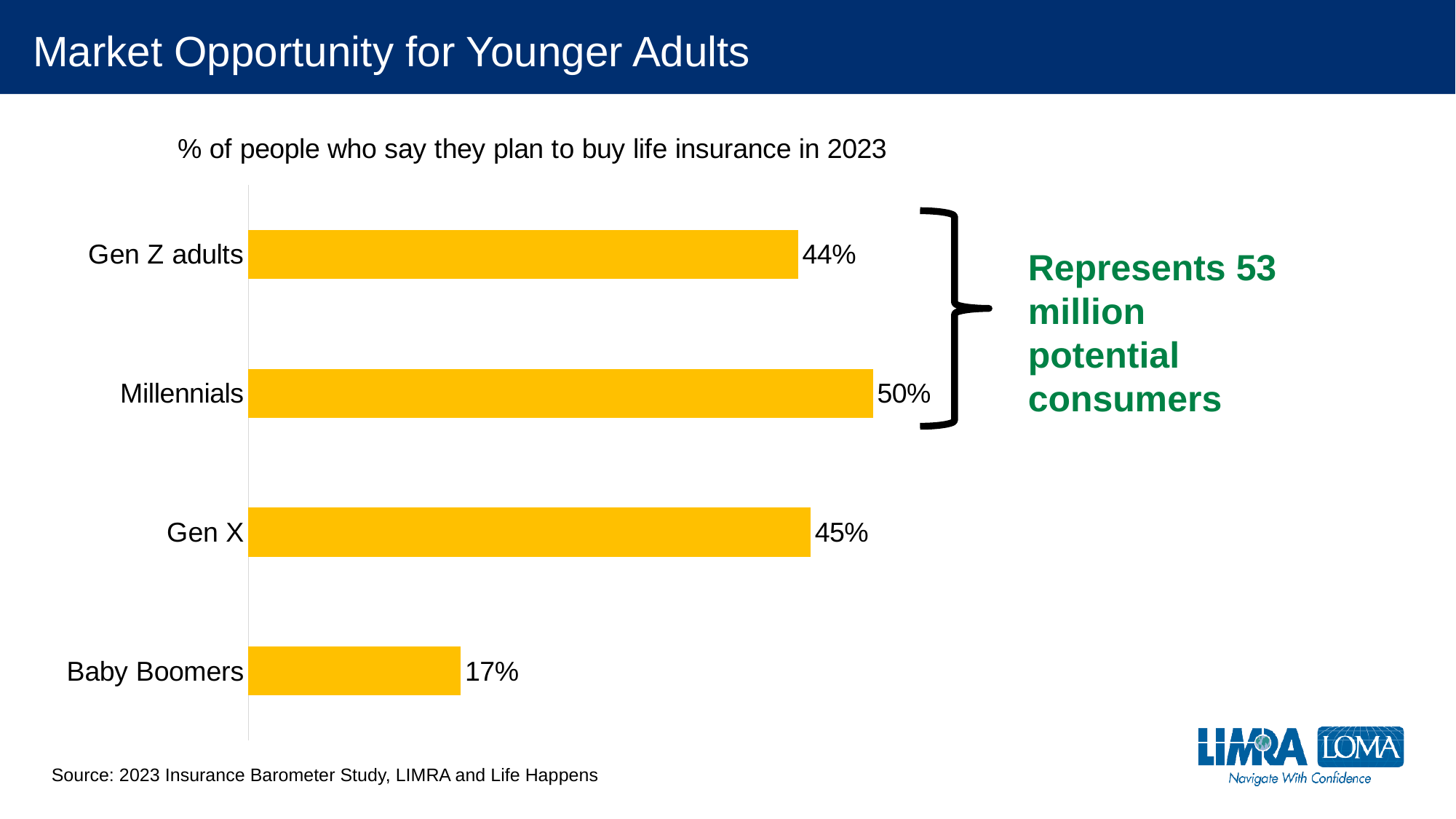
What type of chart is shown on the slide? Bar chart What percentage of Gen Z adults say they plan to buy life insurance in 2023? 44% What is the difference between the Gen X value and the Gen Z adults value? 1% How many generation categories are shown in the chart? 4 What is the value shown for Gen X? 45% Which generation has the highest percentage of people who plan to buy life insurance in 2023? Millennials What is the value shown for Baby Boomers? 17% What is the difference between the Millennials value and the Baby Boomers value? 33% Which generation has the lowest percentage of people who plan to buy life insurance in 2023? Baby Boomers What is the value shown for Millennials? 50% What is the title of the chart? % of people who say they plan to buy life insurance in 2023 Which is larger, the value for Millennials or the value for Gen X? Millennials